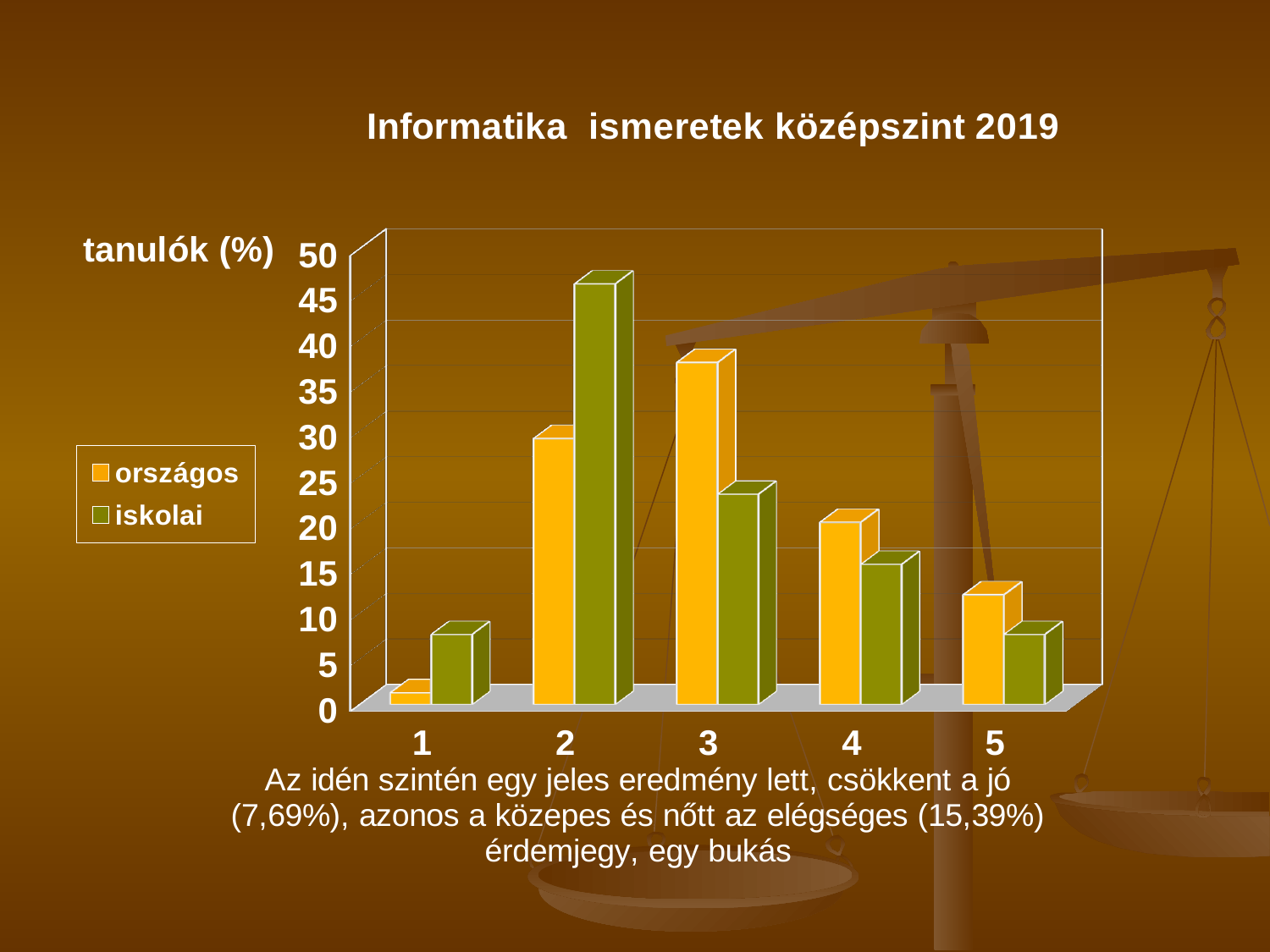
How many series does the legend list? 2 What are the two series named in the legend? országos, iskolai Is the országos value for category 1 greater or less than 5? less Is the iskolai value for category 2 greater or less than 40? greater How many categories are shown on the x axis? 5 For which category is the iskolai value highest? 2 What is the title of the chart? Informatika ismeretek középszint 2019 Is the iskolai value for category 3 greater or less than 30? less For which category is the országos value highest? 3 What kind of chart is shown on the slide? bar chart For category 3, which series has the larger value, országos or iskolai? országos For which category is the országos value lowest? 1